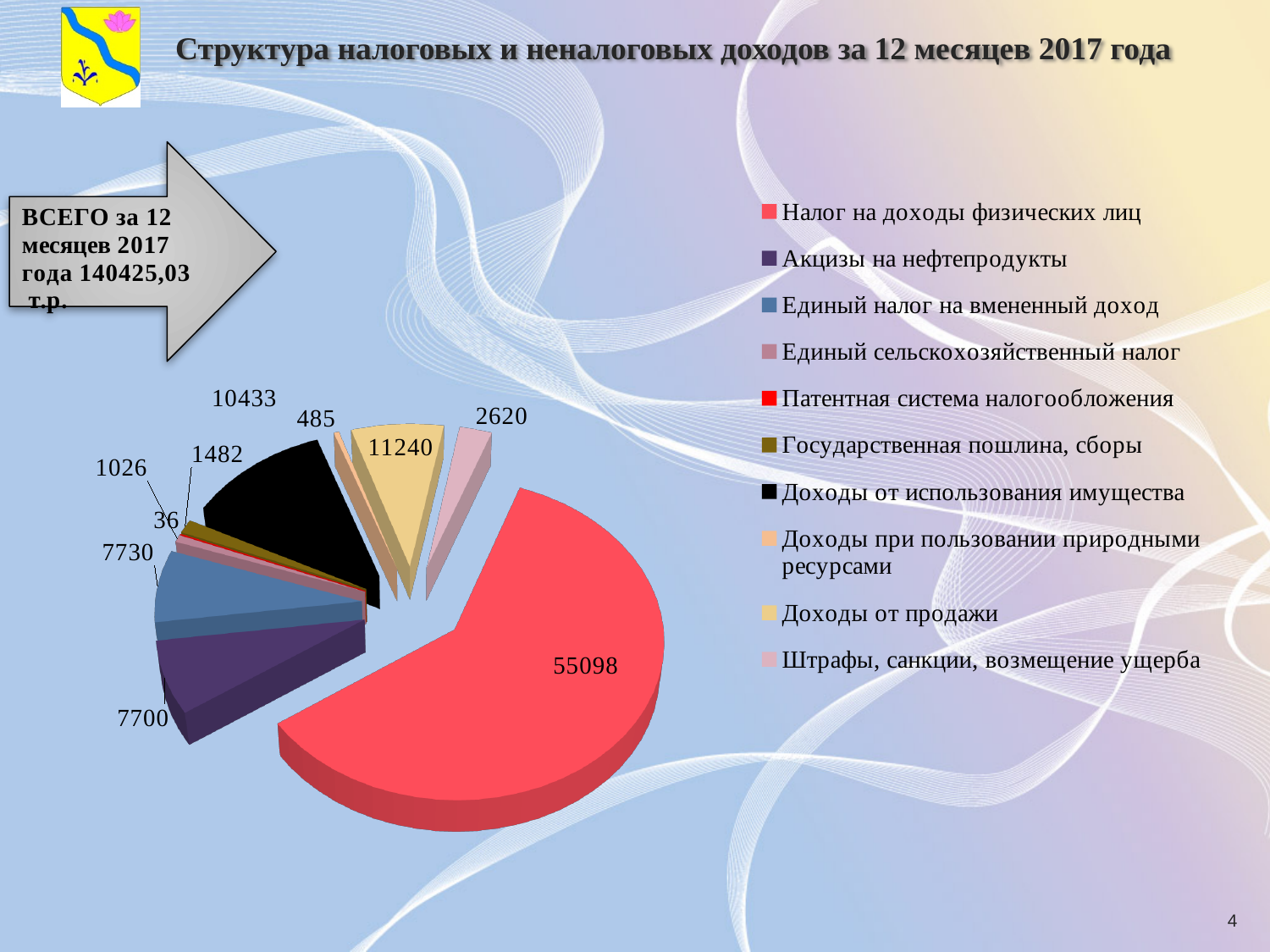
How many entries does the chart legend list? 10 What is the difference between the values for Доходы от продажи and Доходы от использования имущества? 807 Which category has the smallest value in the pie chart? Патентная система налогообложения What kind of chart is shown on the slide? pie chart What is the value for Налог на доходы физических лиц? 55098 How many slices does the pie chart have? 10 Which is larger: the value for Единый налог на вмененный доход or the value for Акцизы на нефтепродукты? Единый налог на вмененный доход What is the value for Доходы от продажи? 11240 What is the value for Штрафы, санкции, возмещение ущерба? 2620 What is the title of the slide containing the chart? Структура налоговых и неналоговых доходов за 12 месяцев 2017 года Which category has the largest slice of the pie? Налог на доходы физических лиц What is the value for Доходы от использования имущества? 10433